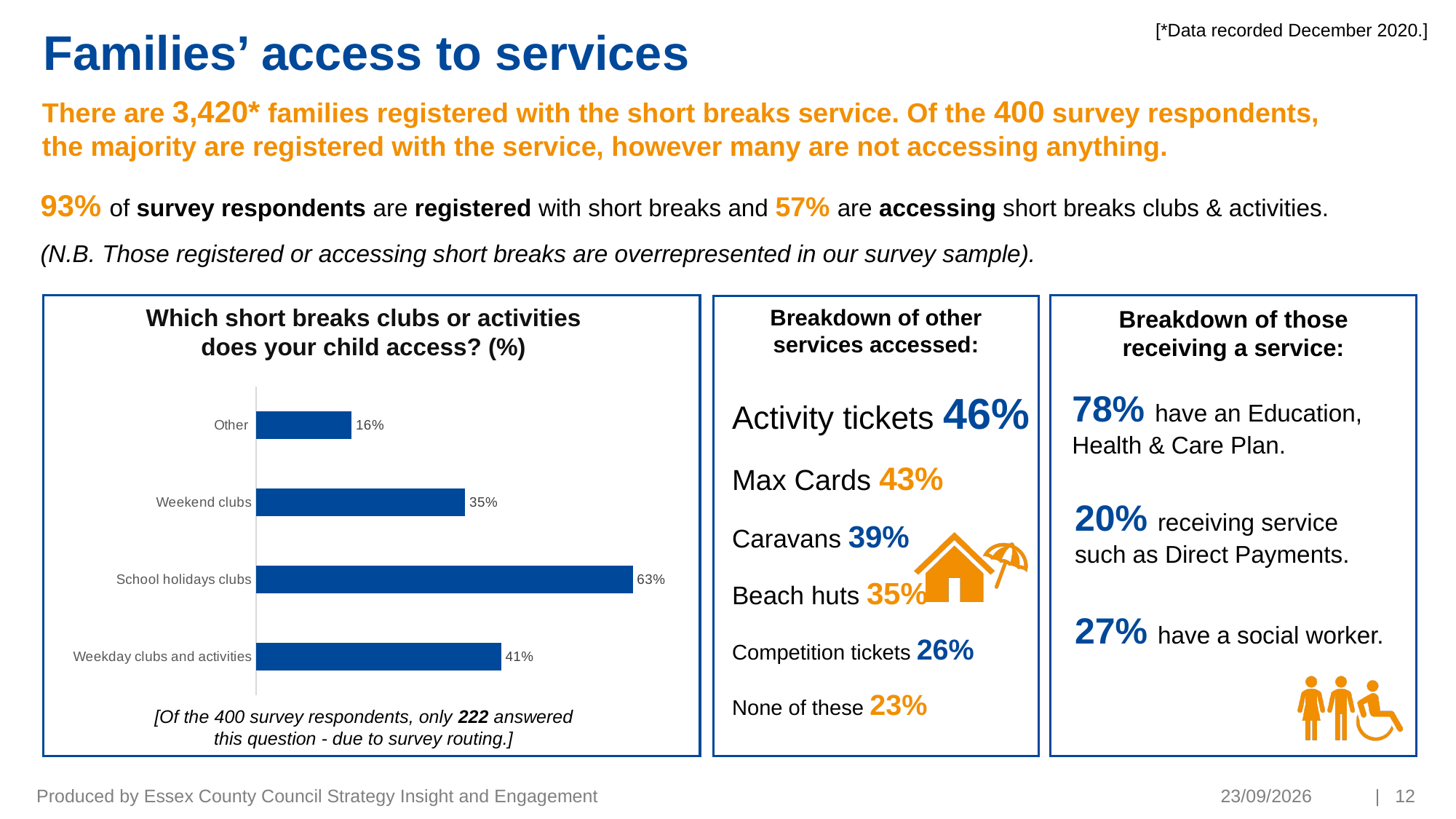
What is the difference between Weekend clubs and Other? 19% What is the title of the chart? Which short breaks clubs or activities does your child access? (%) Which category has the highest value in the chart? School holidays clubs What percentage of respondents' children access School holidays clubs? 63% Which is larger, Weekday clubs and activities or Weekend clubs? Weekday clubs and activities What is the value for Weekend clubs in the chart? 35% Which category has the lowest value in the chart? Other How many categories are shown in the bar chart? 4 What is the value for Weekday clubs and activities? 41% What is the difference between School holidays clubs and Weekday clubs and activities? 22% What type of chart is shown on the slide? Bar chart What is the value for the Other category? 16%